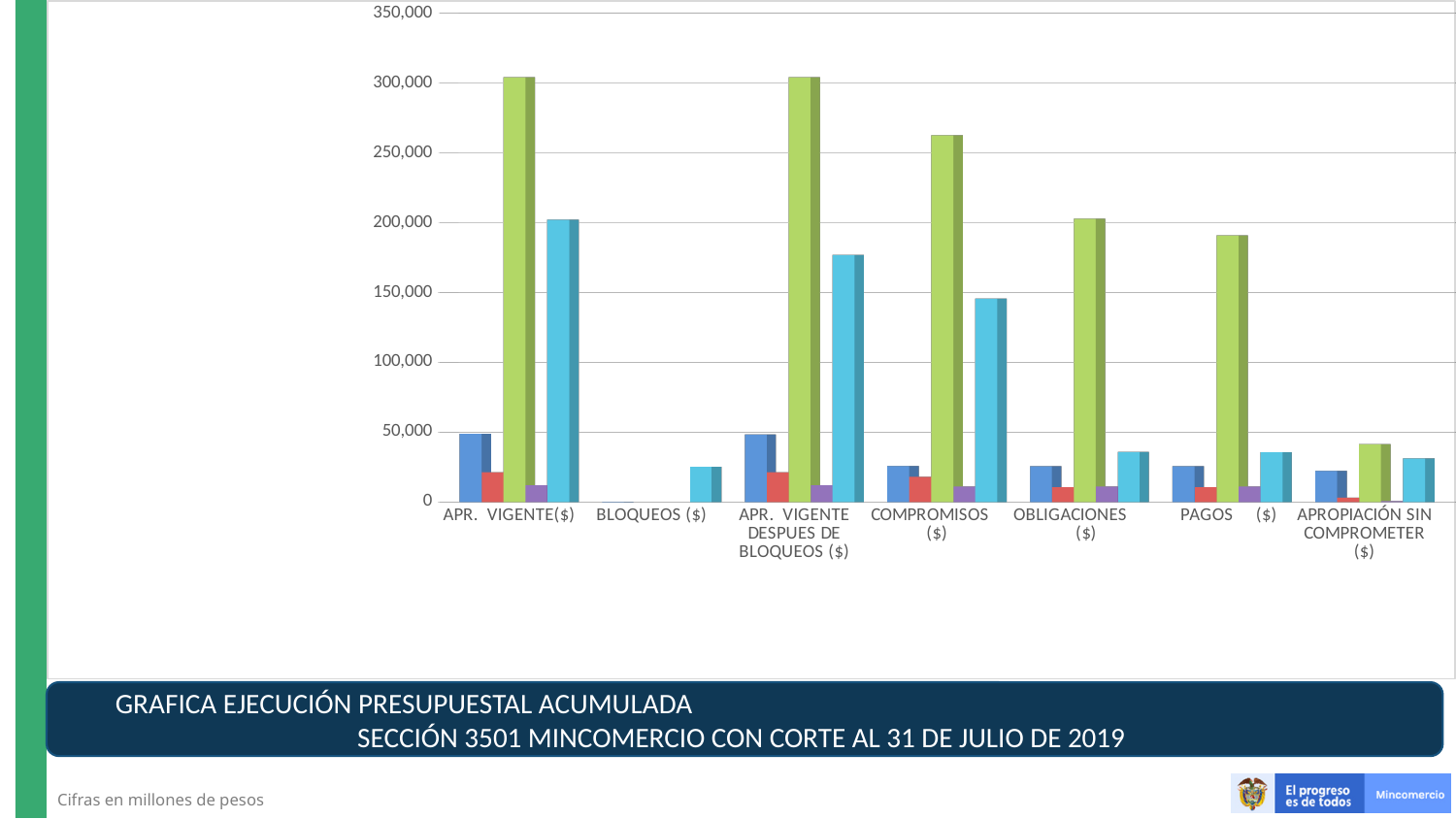
Which category shows only a single visible bar? BLOQUEOS ($) Is the light blue bar for BLOQUEOS ($) greater or less than 50,000? less Do the green bars rise or fall from COMPROMISOS ($) to APROPIACIÓN SIN COMPROMETER ($)? fall Is the green bar for APR. VIGENTE($) greater or less than 250,000? greater Which is larger, the light blue bar for APR. VIGENTE($) or the light blue bar for APR. VIGENTE DESPUES DE BLOQUEOS ($)? APR. VIGENTE($) Is the green bar for PAGOS ($) greater or less than 200,000? less What kind of chart is shown on the slide? bar chart How many categories are shown along the x axis of the chart? 7 What is the highest value shown on the vertical axis of the chart? 350,000 Which is larger, the green bar for COMPROMISOS ($) or the green bar for OBLIGACIONES ($)? COMPROMISOS ($)